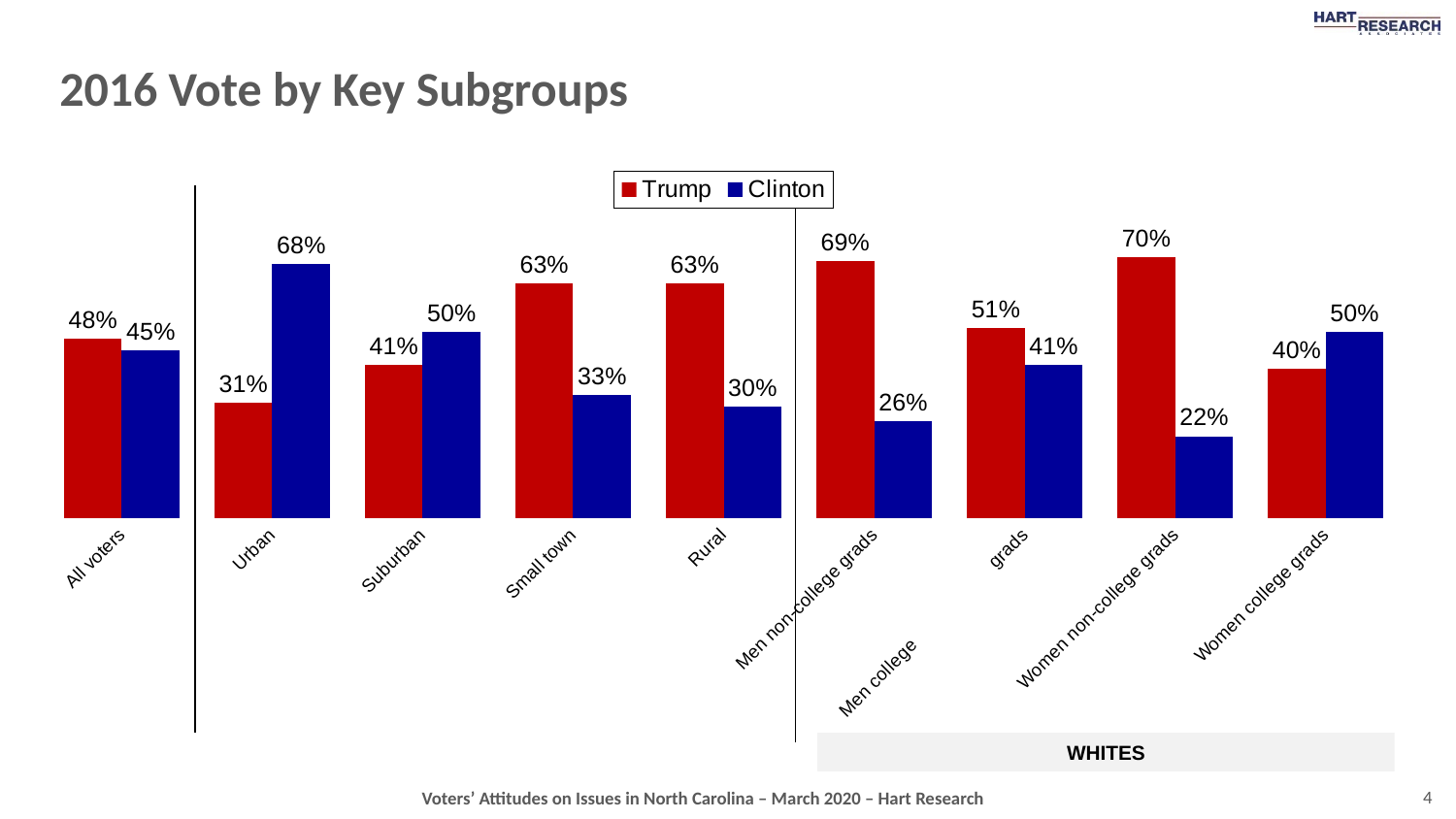
For Suburban voters, who has the larger value, Trump or Clinton? Clinton What kind of chart is shown on the slide? Bar chart Which subgroup has the highest Trump value? Women non-college grads What is Clinton's value for Urban voters? 68% What is the difference between Trump's and Clinton's values for Men non-college grads? 43 percentage points How many subgroups (categories) are shown on the chart? 9 What is Trump's value for Women non-college grads? 70% What is the title of the chart on the slide? 2016 Vote by Key Subgroups How many series does the legend list? 2 What percentage of all voters voted for Trump? 48% What is Clinton's value for Rural voters? 30% Which subgroup has the lowest Clinton value? Women non-college grads